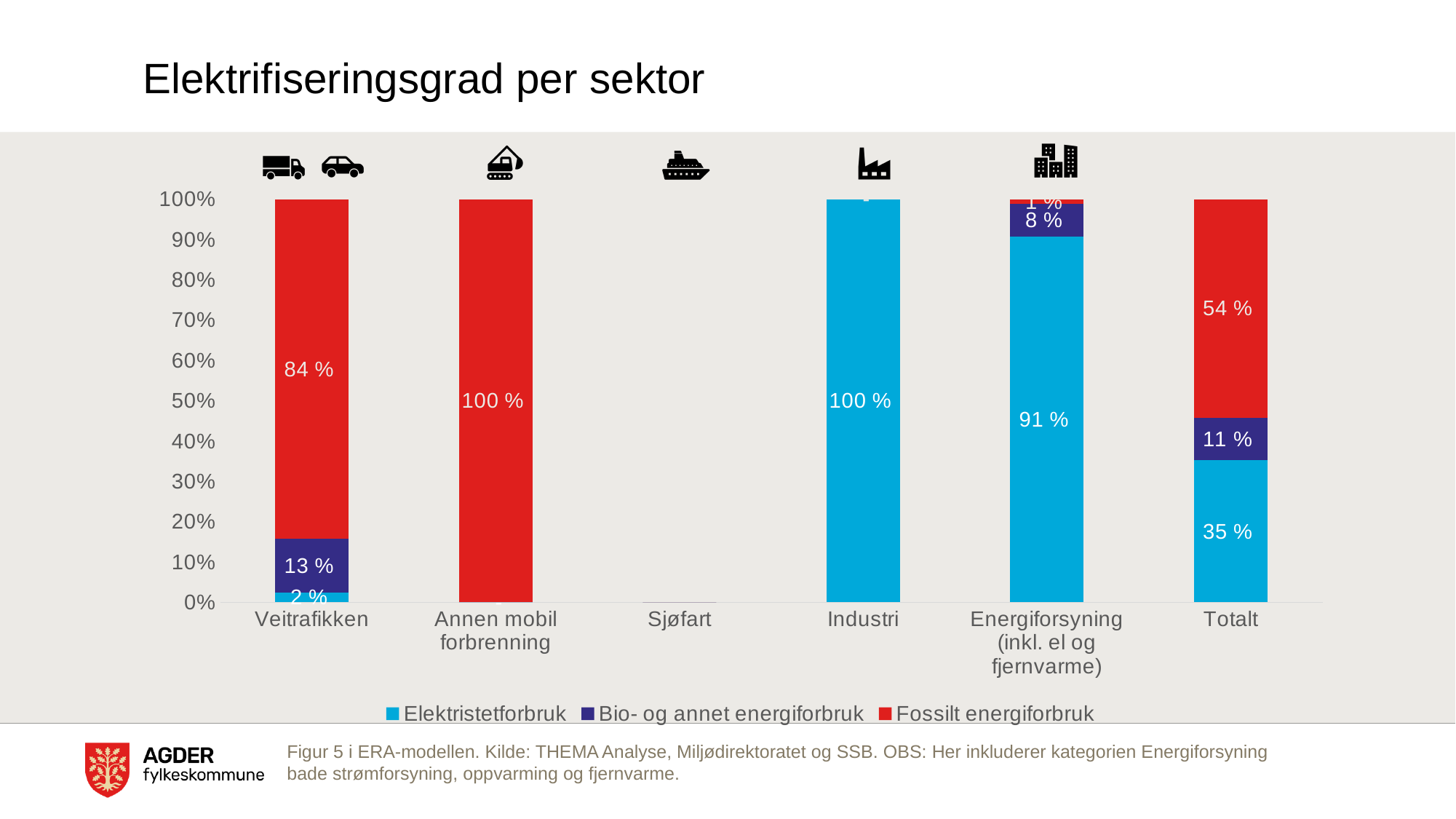
What is the title of the chart? Elektrifiseringsgrad per sektor What type of chart is shown on the slide? stacked bar chart Which sector has the highest Elektristetforbruk share? Industri Which sector has the lowest Elektristetforbruk share among those with a plotted bar? Annen mobil forbrenning How many series does the legend list? 3 What is the Fossilt energiforbruk share for Veitrafikken? 84 % What is the Bio- og annet energiforbruk share for Energiforsyning (inkl. el og fjernvarme)? 8 % What is the Elektristetforbruk share for Industri? 100 % What is the difference between the Fossilt energiforbruk share for Totalt and the Bio- og annet energiforbruk share for Totalt? 43 % What is the Elektristetforbruk share for Totalt? 35 % Which is larger: the Elektristetforbruk share for Energiforsyning (inkl. el og fjernvarme) or for Veitrafikken? Energiforsyning (inkl. el og fjernvarme) What is the Fossilt energiforbruk share for Annen mobil forbrenning? 100 %